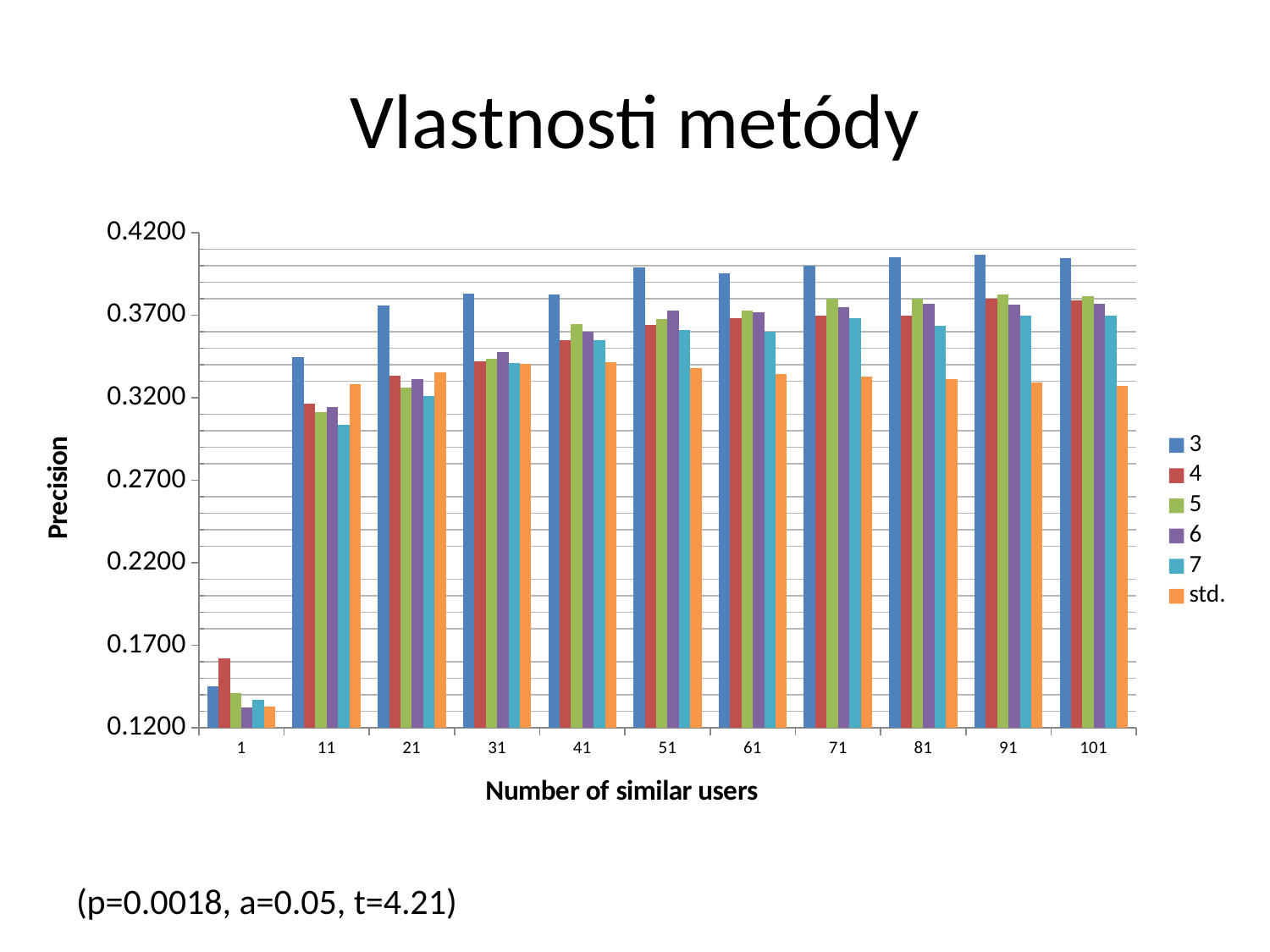
Is the value for series 3 at 101 similar users greater or less than 0.3700? greater Which series has the lowest value at 101 similar users? std. Which is larger at 51 similar users: series 3 or series std.? 3 What is the title of the x axis? Number of similar users Is the value for series std. at 101 similar users greater or less than 0.3700? less Which series has the highest value at 101 similar users? 3 What kind of chart is shown on the slide? bar chart Does the value for series 3 rise or fall from 1 to 11 similar users? rise How many series does the legend list? 6 How many categories are shown on the x axis? 11 For series 3, at which number of similar users is the value lowest? 1 Is the value for series 7 at 11 similar users greater or less than 0.3200? less